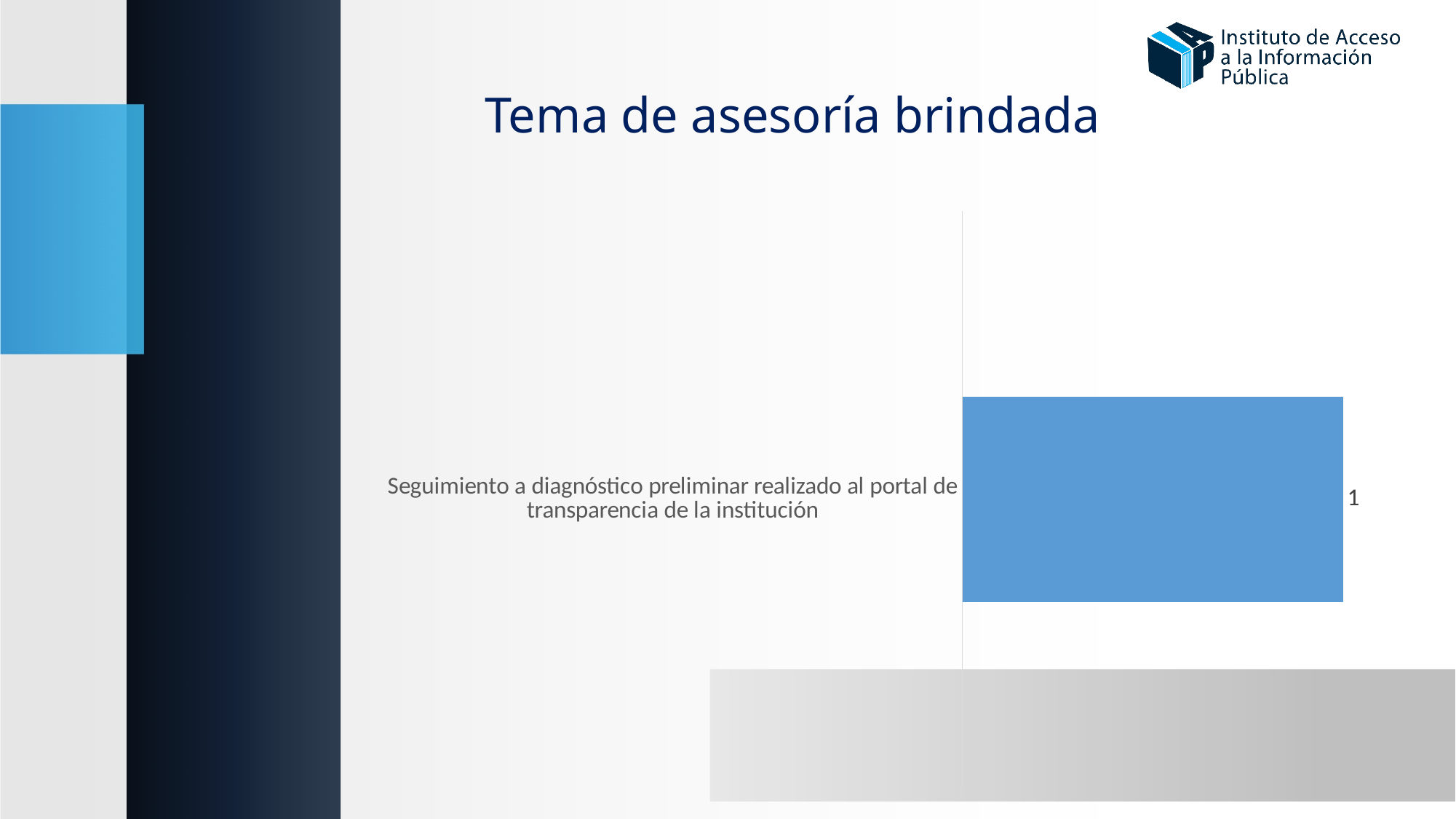
What colour is the bar in the chart? blue What kind of chart is shown on the slide? bar chart What is the title of the slide above the chart? Tema de asesoría brindada Which category has the highest value in the chart? Seguimiento a diagnóstico preliminar realizado al portal de transparencia de la institución What is the value for "Seguimiento a diagnóstico preliminar realizado al portal de transparencia de la institución"? 1 How many categories does the chart show? 1